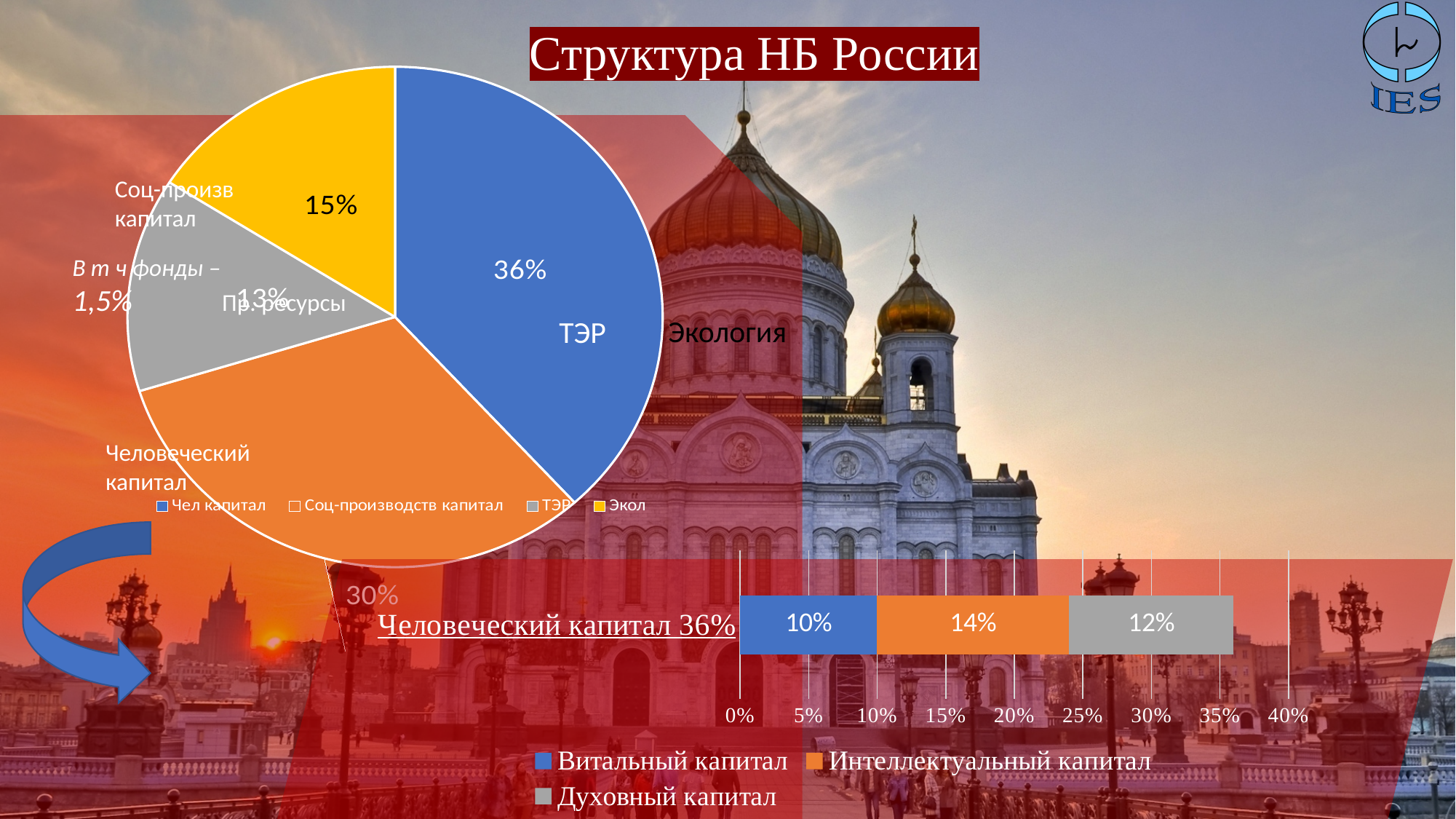
In the pie chart 'Структура НБ России', which legend entry has the smallest slice? ТЭР In the pie chart 'Структура НБ России', which legend entry has the largest slice? Чел капитал In the pie chart 'Структура НБ России', what percentage is shown for the grey slice (ТЭР)? 13% In the bar chart at the bottom of the slide, what is the total of the stacked bar (Витальный, Интеллектуальный and Духовный капитал)? 36% In the pie chart 'Структура НБ России', what percentage is shown for the yellow slice (Экол)? 15% In the bar chart at the bottom of the slide, what is the value for Интеллектуальный капитал? 14% In the pie chart 'Структура НБ России', what percentage is shown for the blue slice (Чел капитал)? 36% In the pie chart 'Структура НБ России', what is the difference between the blue slice (36%) and the yellow slice (15%)? 21 percentage points In the bar chart at the bottom of the slide, what is the value for Духовный капитал? 12% In the bar chart at the bottom of the slide, what is the value for Витальный капитал? 10% In the bar chart at the bottom of the slide, which is larger: Интеллектуальный капитал or Витальный капитал? Интеллектуальный капитал In the pie chart 'Структура НБ России', how many entries does the legend list? 4